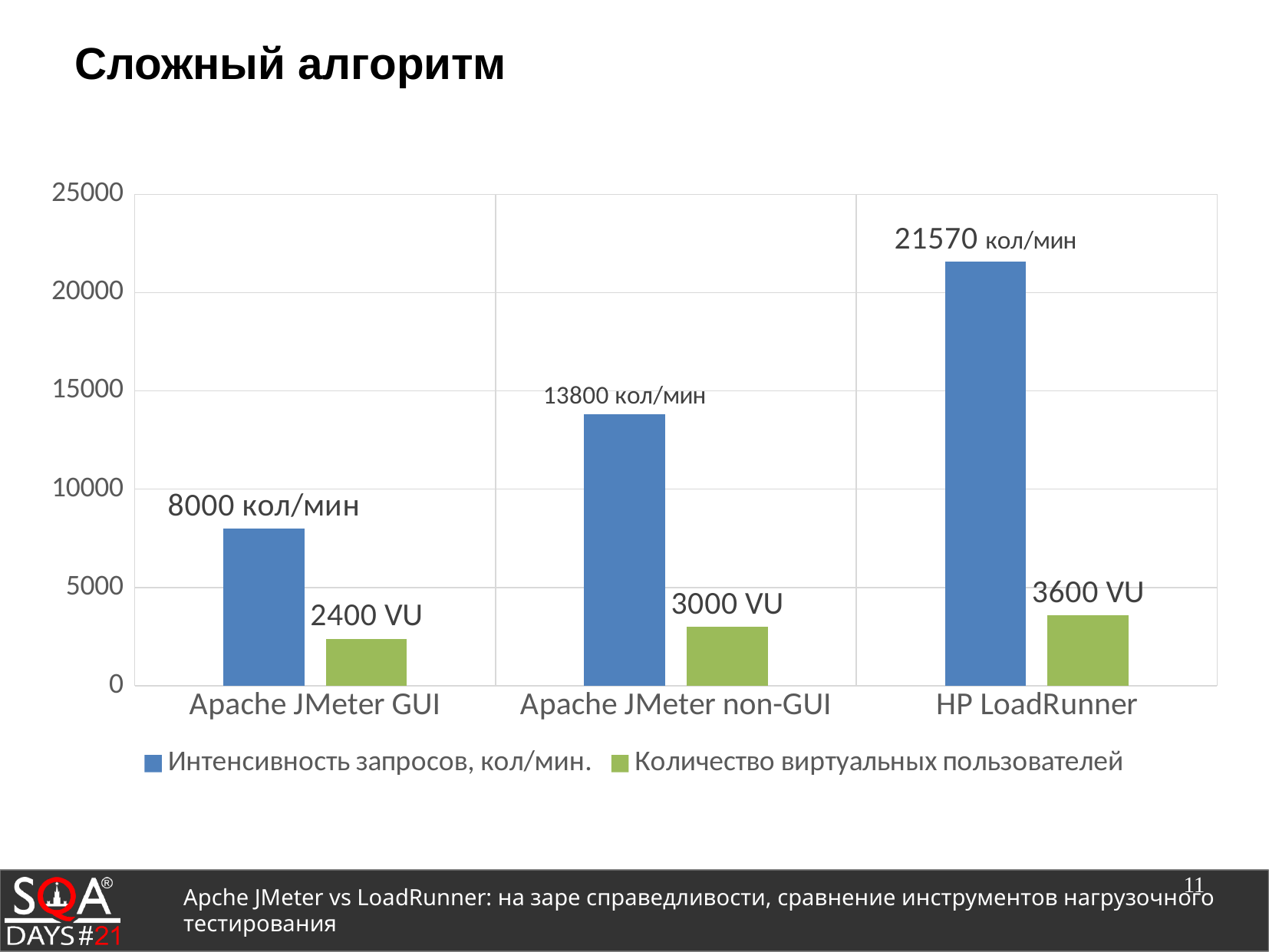
Which is larger: the request intensity for Apache JMeter non-GUI or for Apache JMeter GUI? Apache JMeter non-GUI Is the request intensity for HP LoadRunner greater or less than 20000? greater What is the difference in virtual users between HP LoadRunner and Apache JMeter non-GUI? 600 VU What is the request intensity for Apache JMeter non-GUI? 13800 кол/мин What is the number of virtual users (Количество виртуальных пользователей) for Apache JMeter GUI? 2400 VU What is the difference in request intensity between HP LoadRunner and Apache JMeter GUI? 13570 кол/мин What kind of chart is shown on the slide? Bar chart Which category has the highest request intensity? HP LoadRunner Which category has the lowest number of virtual users? Apache JMeter GUI How many categories are shown on the x axis? 3 What is the request intensity (Интенсивность запросов) for HP LoadRunner? 21570 кол/мин How many series does the legend list? 2